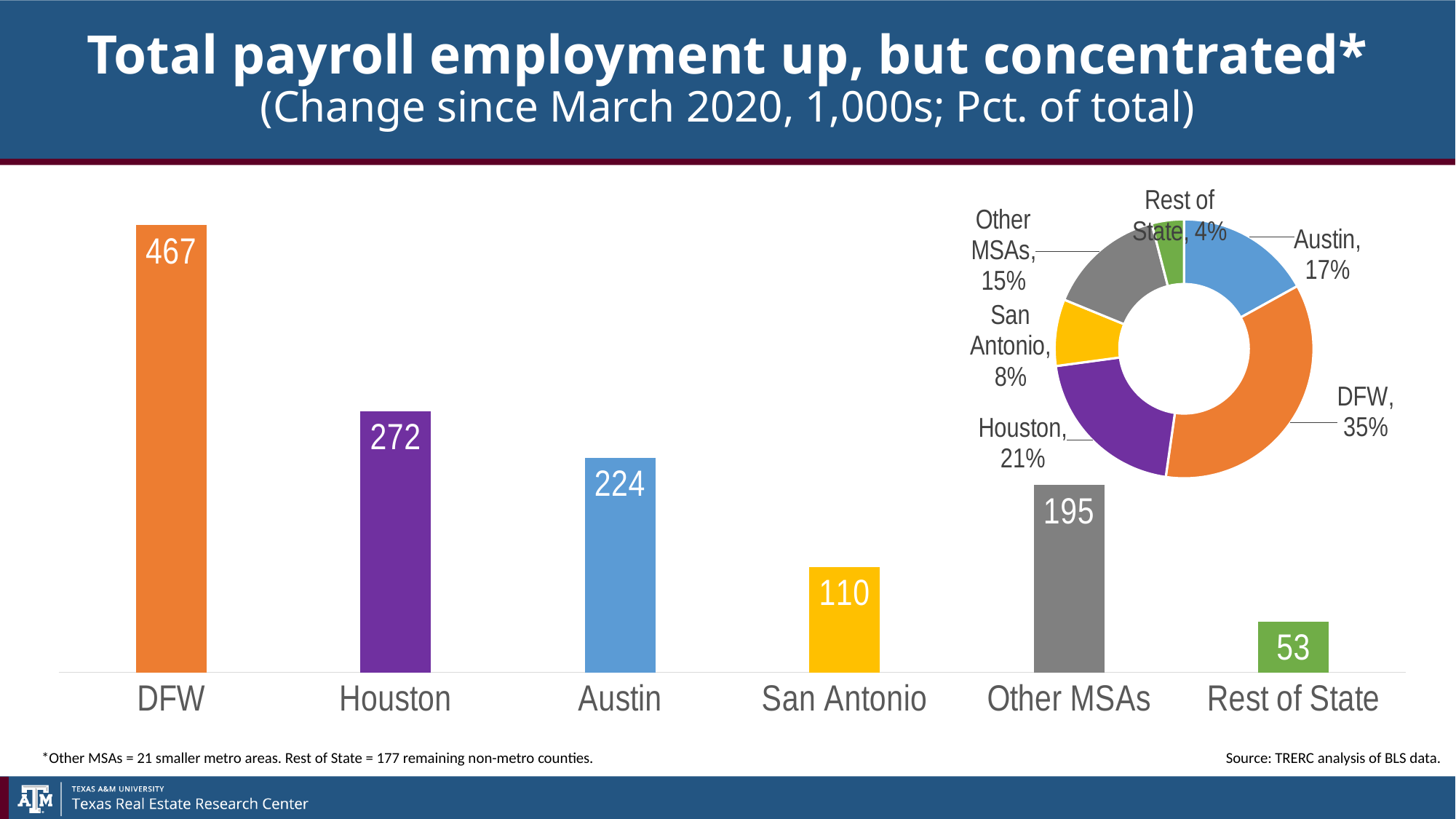
In the donut chart, what share of the total does Houston account for? 21% What kind of chart is the chart on the left side of the slide? Bar chart In the bar chart, what is the value for Rest of State? 53 What kind of chart is the chart in the upper right of the slide? Donut chart In the bar chart, what is the value for Houston? 272 In the bar chart, which category has the lowest value? Rest of State How many categories are shown in the bar chart? 6 In the bar chart, what is the difference between the values for DFW and Houston? 195 In the bar chart, which category has the highest value? DFW In the bar chart, which is larger, the value for Austin or the value for Other MSAs? Austin In the bar chart, what is the value for DFW? 467 In the donut chart, what share of the total does San Antonio account for? 8%